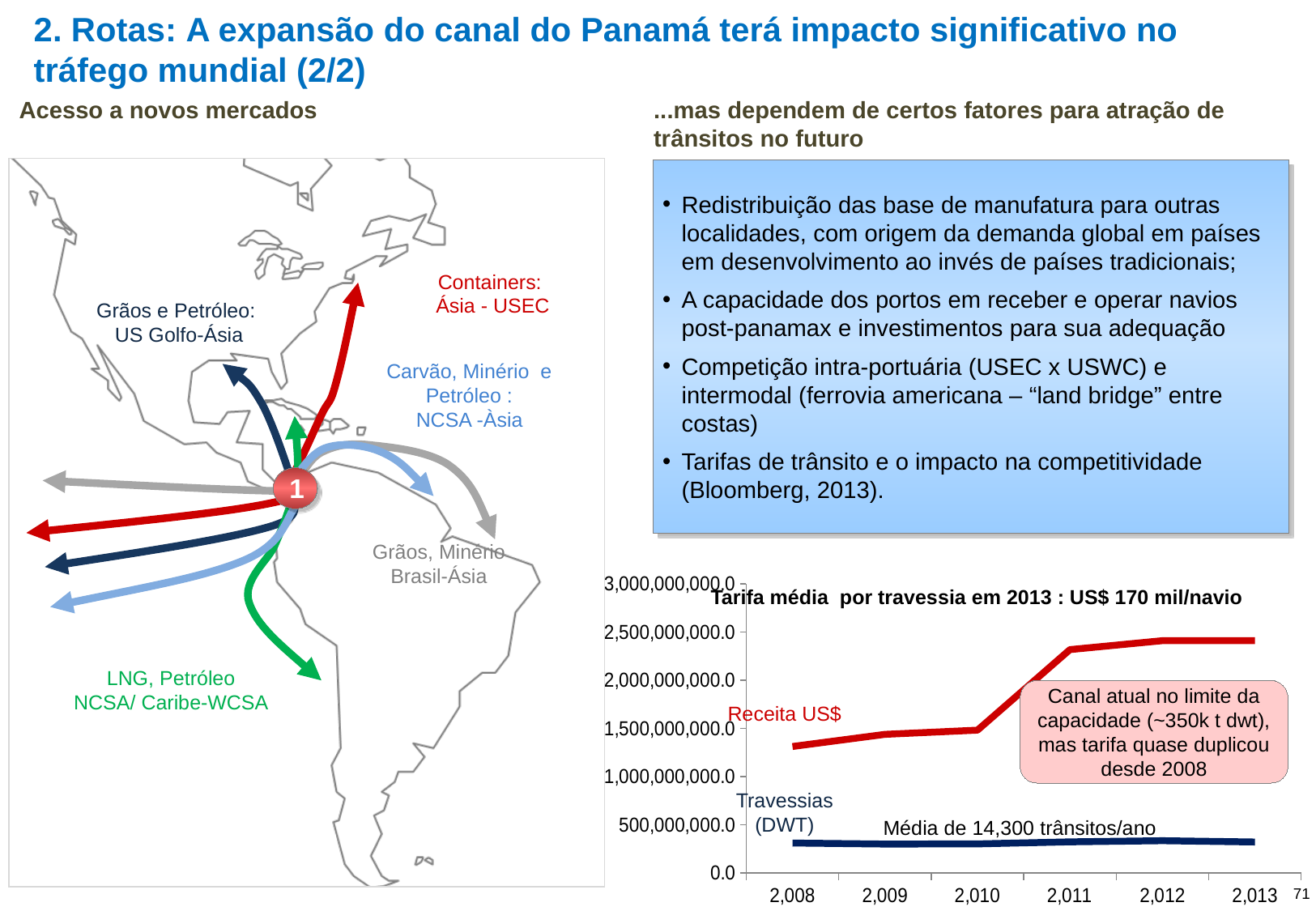
What kind of chart is shown at the bottom right of the slide? line chart In the line chart, which year has the lowest value for Receita US$? 2,008 In the line chart, does the Receita US$ series rise or fall from 2008 to 2013? rise How many years are shown on the x axis of the line chart? 6 What colour is the Receita US$ line in the chart? red What is the title printed above the line chart? Tarifa média por travessia em 2013 : US$ 170 mil/navio In the line chart, is the Receita US$ value for 2008 greater or less than 1,500,000,000.0? less In the line chart, which series has the larger value in 2013, Receita US$ or Travessias (DWT)? Receita US$ In the line chart, is the Receita US$ value for 2010 greater or less than 2,000,000,000.0? less In the line chart, is the Receita US$ value for 2013 greater or less than 2,000,000,000.0? greater How many data series are plotted in the line chart? 2